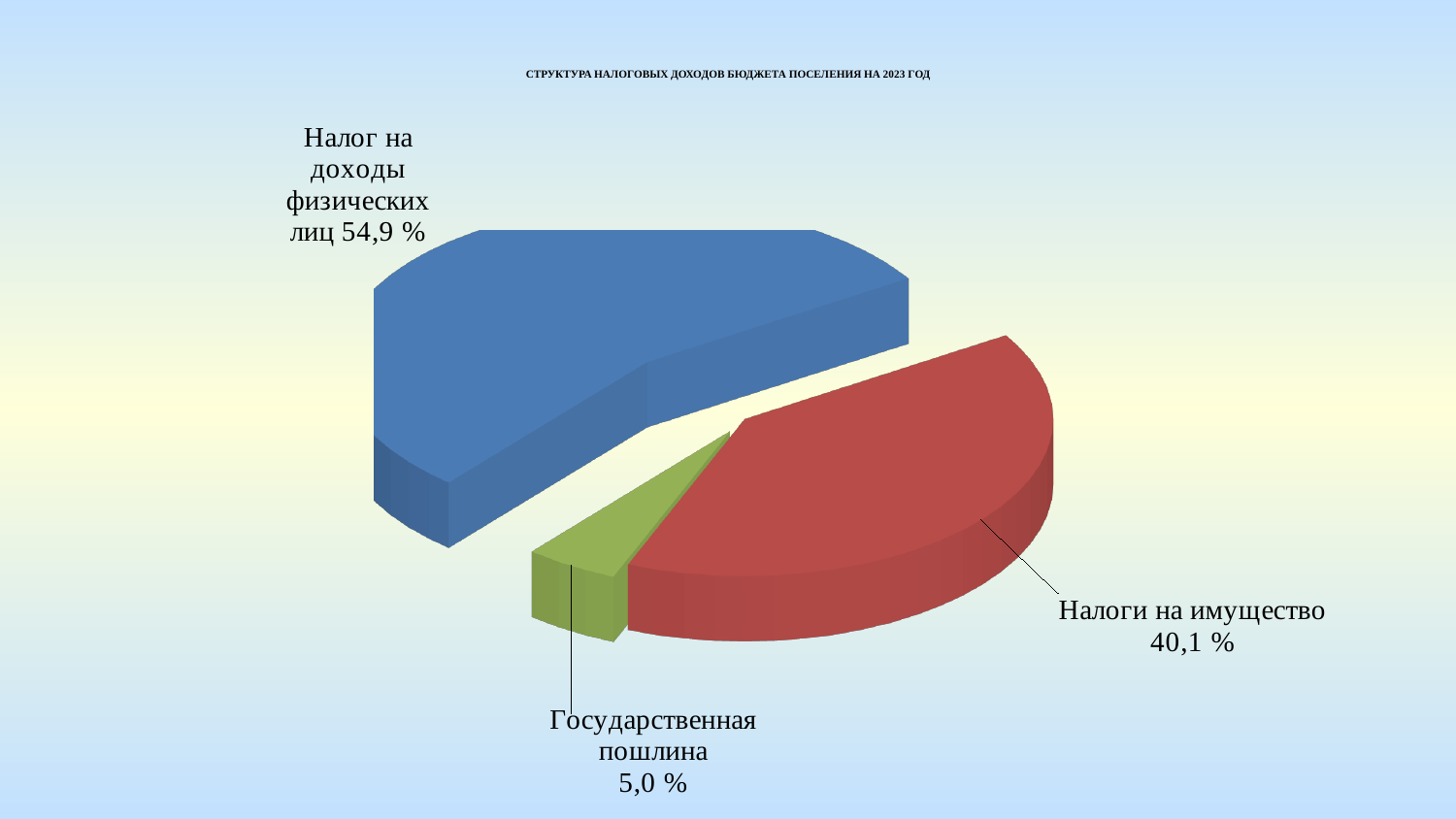
What colour is the slice for "Налоги на имущество"? Red What is the combined share of "Налоги на имущество" and "Государственная пошлина"? 45,1 % What share of the pie does "Налог на доходы физических лиц" represent? 54,9 % Which category has the smallest slice of the pie? Государственная пошлина How many categories are shown in the pie chart? 3 Which is larger: the share for "Налоги на имущество" or the share for "Государственная пошлина"? Налоги на имущество Which category has the largest slice of the pie? Налог на доходы физических лиц What is the title of the chart? СТРУКТУРА НАЛОГОВЫХ ДОХОДОВ БЮДЖЕТА ПОСЕЛЕНИЯ НА 2023 ГОД What is the difference in percentage points between "Налог на доходы физических лиц" and "Налоги на имущество"? 14,8 What share of the pie does "Налоги на имущество" represent? 40,1 % What share of the pie does "Государственная пошлина" represent? 5,0 % What kind of chart is shown on the slide? Pie chart